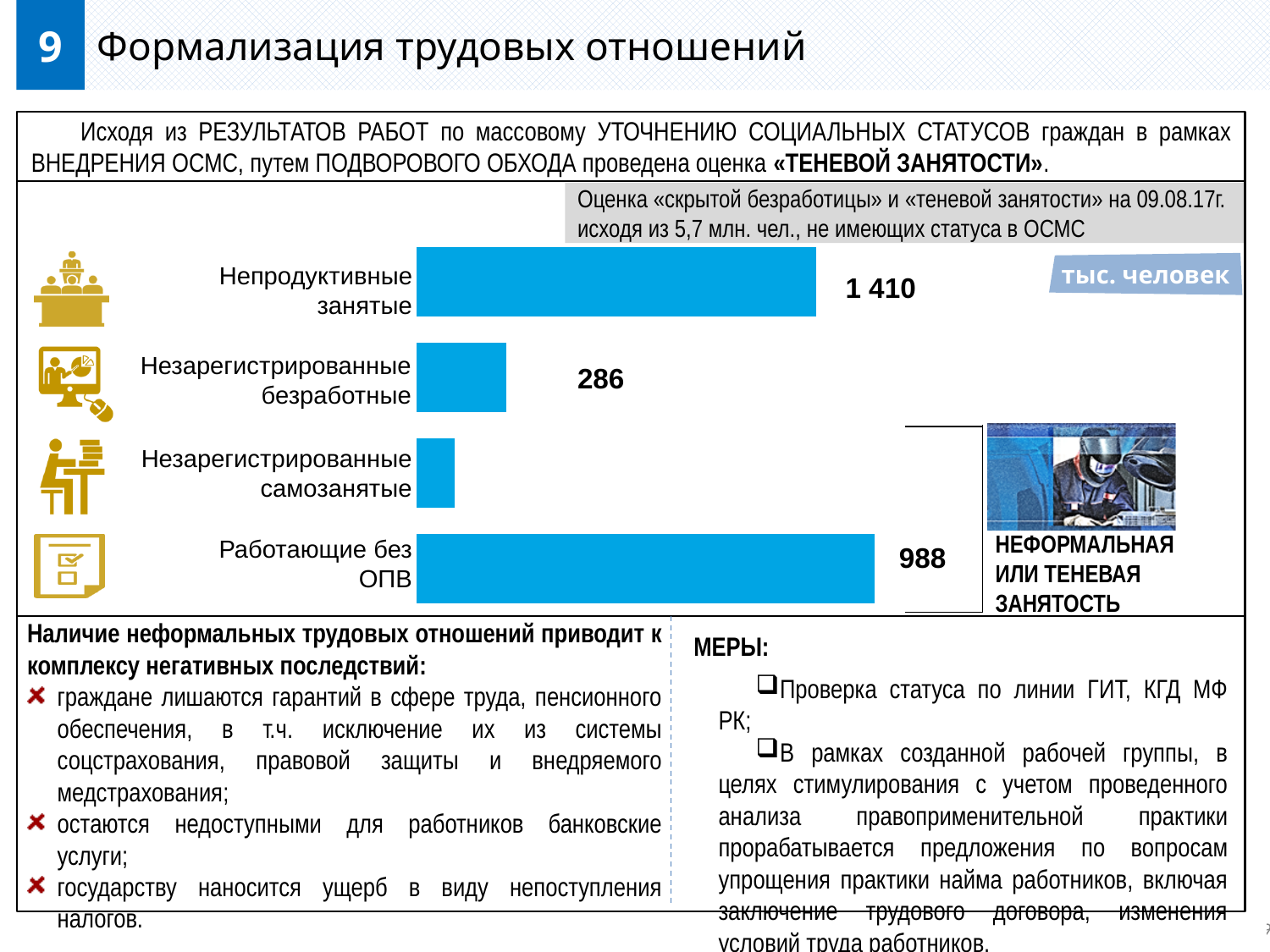
What is the difference between the values for Непродуктивные занятые and Незарегистрированные безработные? 1 124 What is the value for Работающие без ОПВ in the bar chart? 988 Which is larger: the value for Работающие без ОПВ or the value for Незарегистрированные безработные? Работающие без ОПВ What type of chart is shown on the slide? Bar chart What is the value for Непродуктивные занятые in the bar chart? 1 410 What is the difference between the values for Работающие без ОПВ and Незарегистрированные безработные? 702 What is the difference between the values for Непродуктивные занятые and Работающие без ОПВ? 422 Which category has the lowest value in the bar chart? Незарегистрированные самозанятые What is the value for Незарегистрированные безработные in the bar chart? 286 In what units are the values of the bar chart given? тыс. человек How many categories are shown in the bar chart? 4